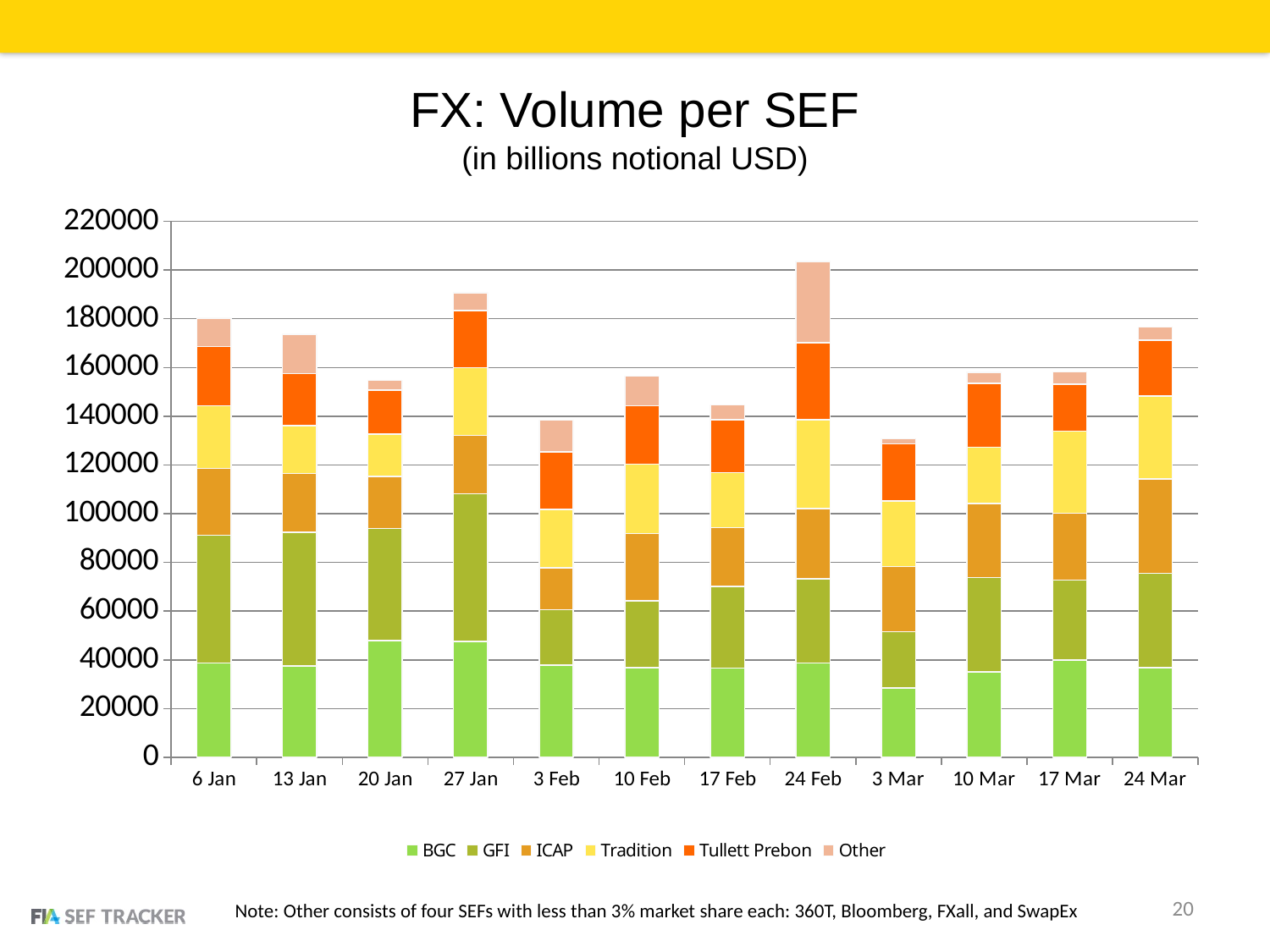
What is the title of the chart? FX: Volume per SEF Which has the larger total volume, 27 Jan or 13 Jan? 27 Jan How many weekly dates are shown along the x axis? 12 What kind of chart is shown on the slide? Stacked bar chart Is the total volume for 10 Feb greater or less than 140000? greater Which series is shown at the bottom of each stacked bar? BGC Is the total volume for 3 Mar greater or less than 140000? less Which date has the highest total volume? 24 Feb Is the total volume for 24 Feb greater or less than 180000? greater Which date has the lowest total volume? 3 Mar How many series does the legend list? 6